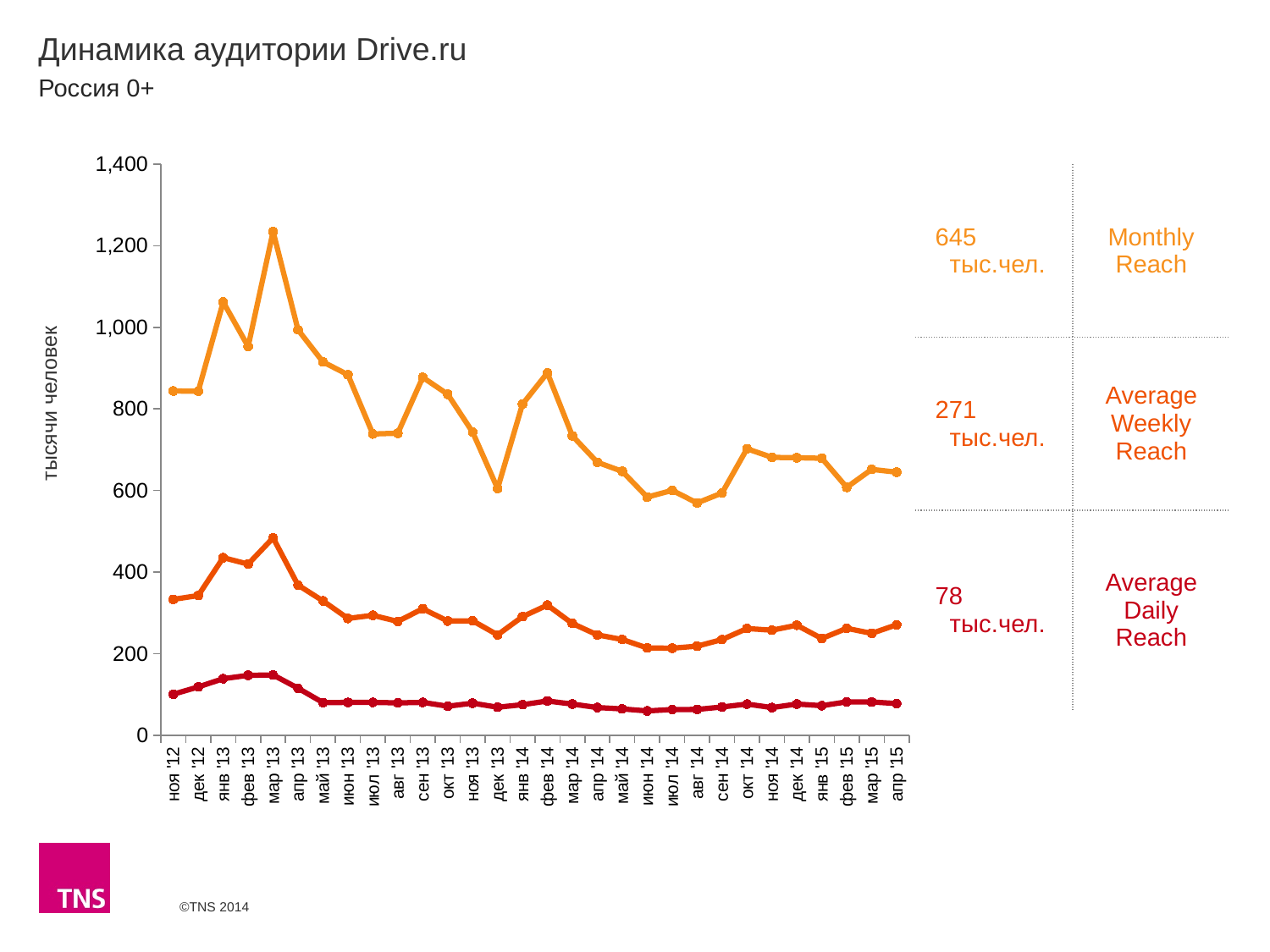
How many series (lines) are plotted on the chart? 3 What kind of chart is shown on the slide? line chart Which is larger: the Monthly Reach for ноя '12 or for апр '15? ноя '12 What is the Monthly Reach value for апр '15? 645 тыс.чел. Is the Monthly Reach value for мар '13 greater or less than 1,200? greater What is the Average Daily Reach value for апр '15? 78 тыс.чел. Is the Monthly Reach value for дек '13 greater or less than 700? less In which month does the Monthly Reach line reach its highest value? мар '13 What is the Average Weekly Reach value for апр '15? 271 тыс.чел. What is the difference between the Monthly Reach and the Average Weekly Reach for апр '15? 374 тыс.чел. How many monthly points are plotted along the x axis? 30 In which month does the Average Weekly Reach line reach its highest value? мар '13